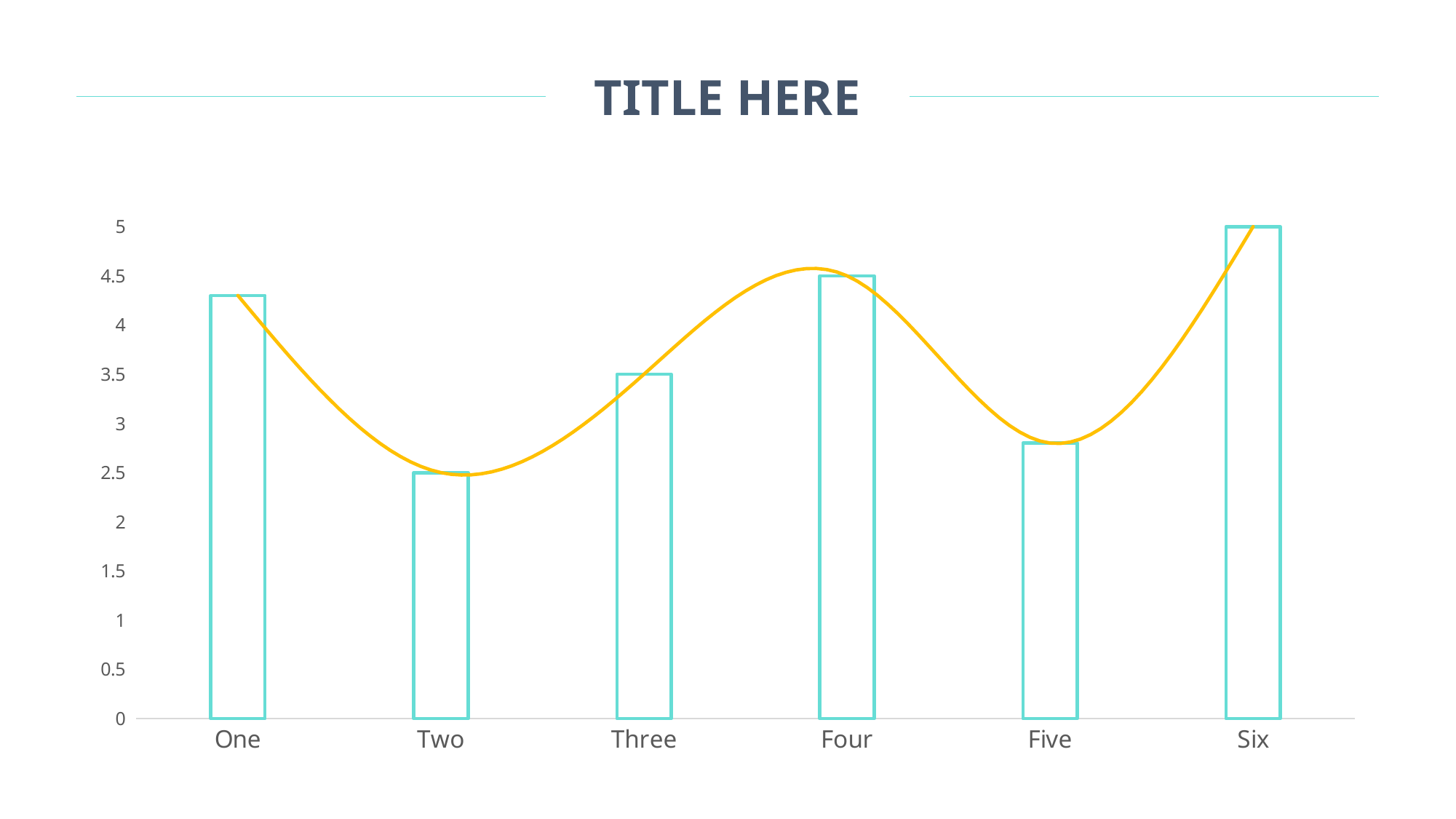
Is the value for Five greater or less than 3? less What is the value of the bar for Four? 4.5 Which category has the lowest bar? Two Which bar is taller, Three or Five? Three What is the value of the bar for Six? 5 What is the title of the slide? TITLE HERE How many categories are shown on the x axis? 6 What is the difference between the bar values for Six and Two? 2.5 Is the value for One greater or less than 4? greater What is the value of the bar for Two? 2.5 What is the value of the bar for Three? 3.5 Which category has the highest bar? Six